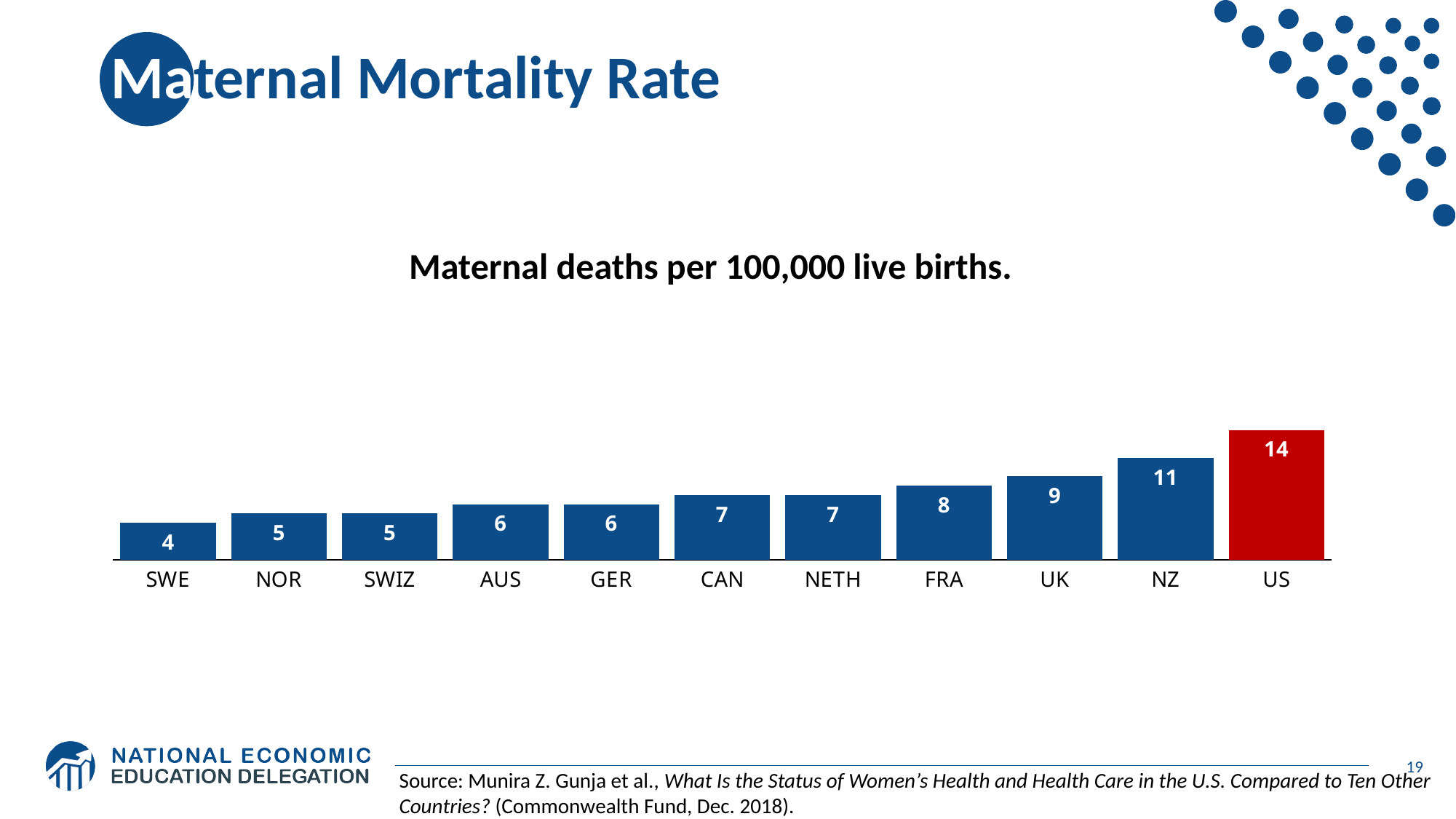
What is the value shown for NZ? 11 What is the difference between the values for the US and the UK? 5 How many countries are shown on the chart? 11 What kind of chart is shown on the slide? Bar chart Which country has the highest maternal mortality rate on the chart? US What is the value shown for SWE? 4 What is the value shown for FRA? 8 Which has a higher value, NZ or FRA? NZ Which bar is coloured red rather than blue? US Which country has the lowest maternal mortality rate on the chart? SWE Do the values rise or fall moving from left to right along the x axis? Rise What is the maternal mortality rate shown for the US? 14